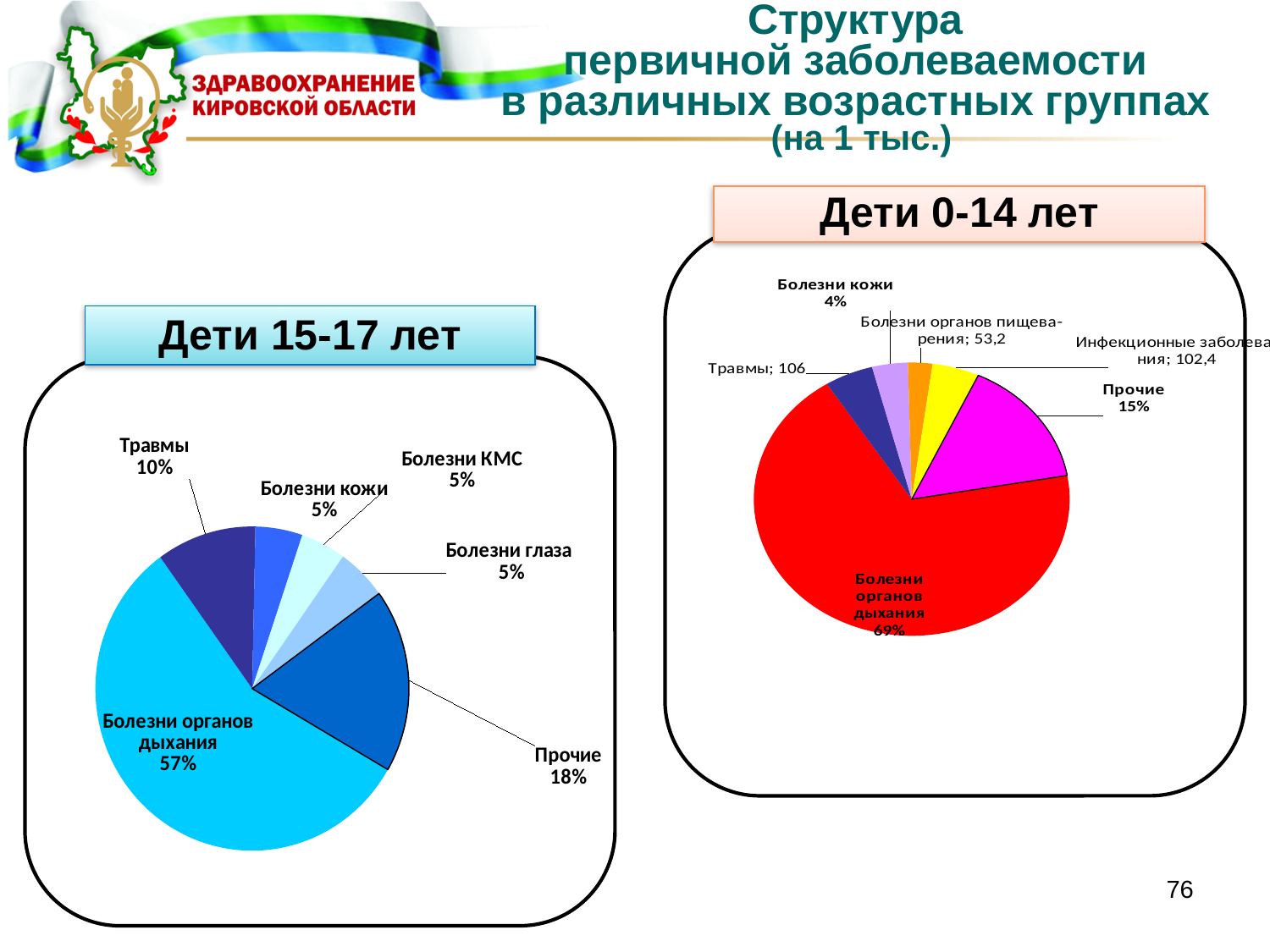
In the "Дети 15-17 лет" pie chart, what share is labelled for Болезни органов дыхания? 57% In the "Дети 15-17 лет" pie chart, what share is labelled for Прочие? 18% In the "Дети 0-14 лет" pie chart, which category has the largest slice? Болезни органов дыхания In the "Дети 0-14 лет" pie chart, what value is labelled for Инфекционные заболевания? 102,4 In the "Дети 15-17 лет" pie chart, which is larger: Прочие or Травмы? Прочие In the "Дети 15-17 лет" pie chart, which category has the largest slice? Болезни органов дыхания In the "Дети 0-14 лет" pie chart, what share is labelled for Болезни органов дыхания? 69% In the "Дети 15-17 лет" pie chart, what is the difference in percentage points between Болезни органов дыхания and Прочие? 39 What kind of chart is shown under the heading "Дети 15-17 лет"? pie chart In the "Дети 15-17 лет" pie chart, what share is labelled for Травмы? 10% In the "Дети 0-14 лет" pie chart, what value is labelled for Травмы? 106 In the "Дети 15-17 лет" pie chart, how many slices are there? 6